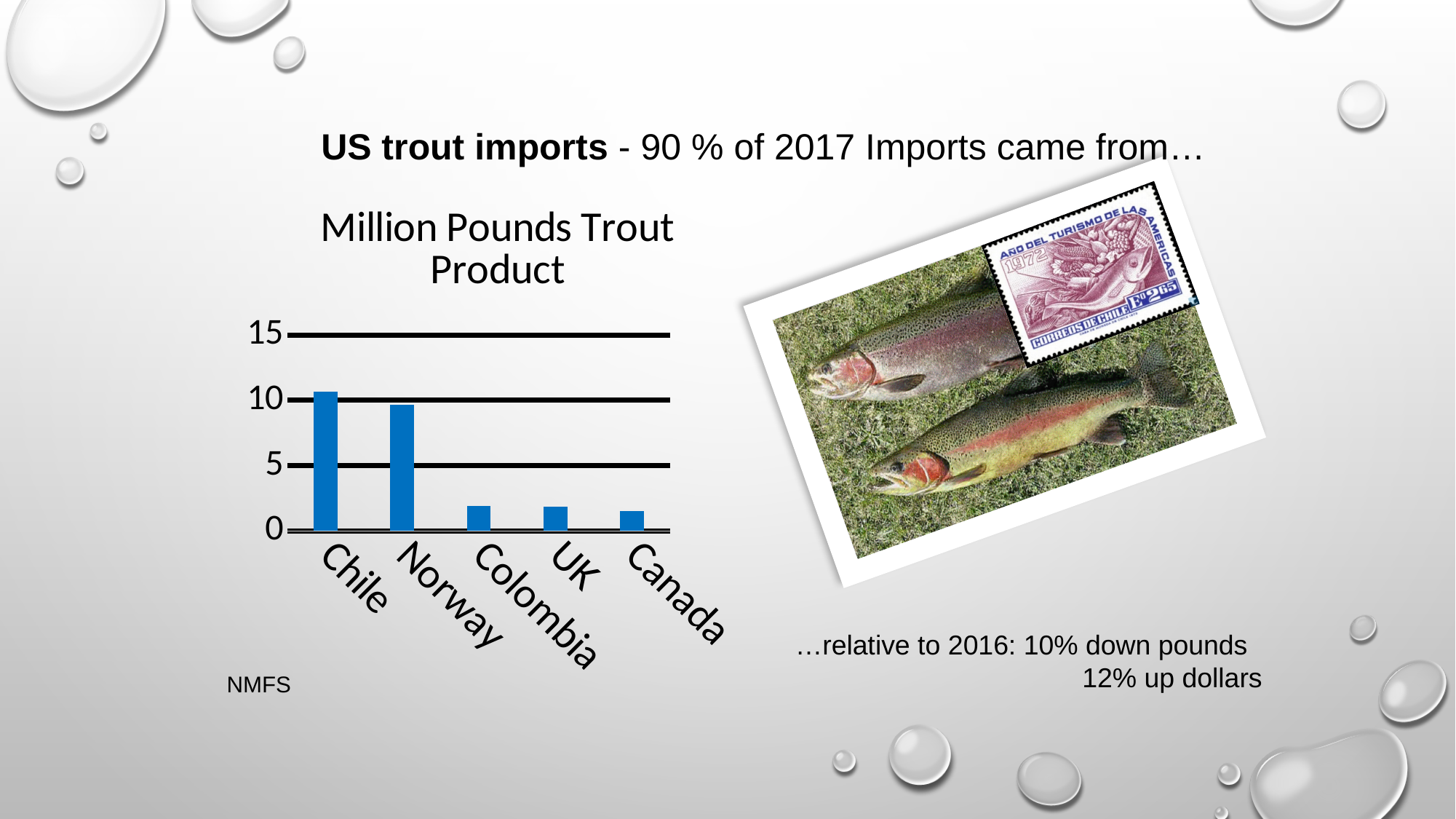
Is the value for Chile greater or less than 10? greater Is the value for Norway greater or less than 10? less What kind of chart is shown on the slide? bar chart Is the value for Colombia greater or less than 5? less What is the title of the chart? Million Pounds Trout Product Which country has the highest value in the chart? Chile Which is larger, the value for Chile or the value for Colombia? Chile Do the values rise or fall moving from Chile to Canada along the x axis? fall Which is larger, the value for Norway or the value for UK? Norway How many countries are shown on the x axis of the chart? 5